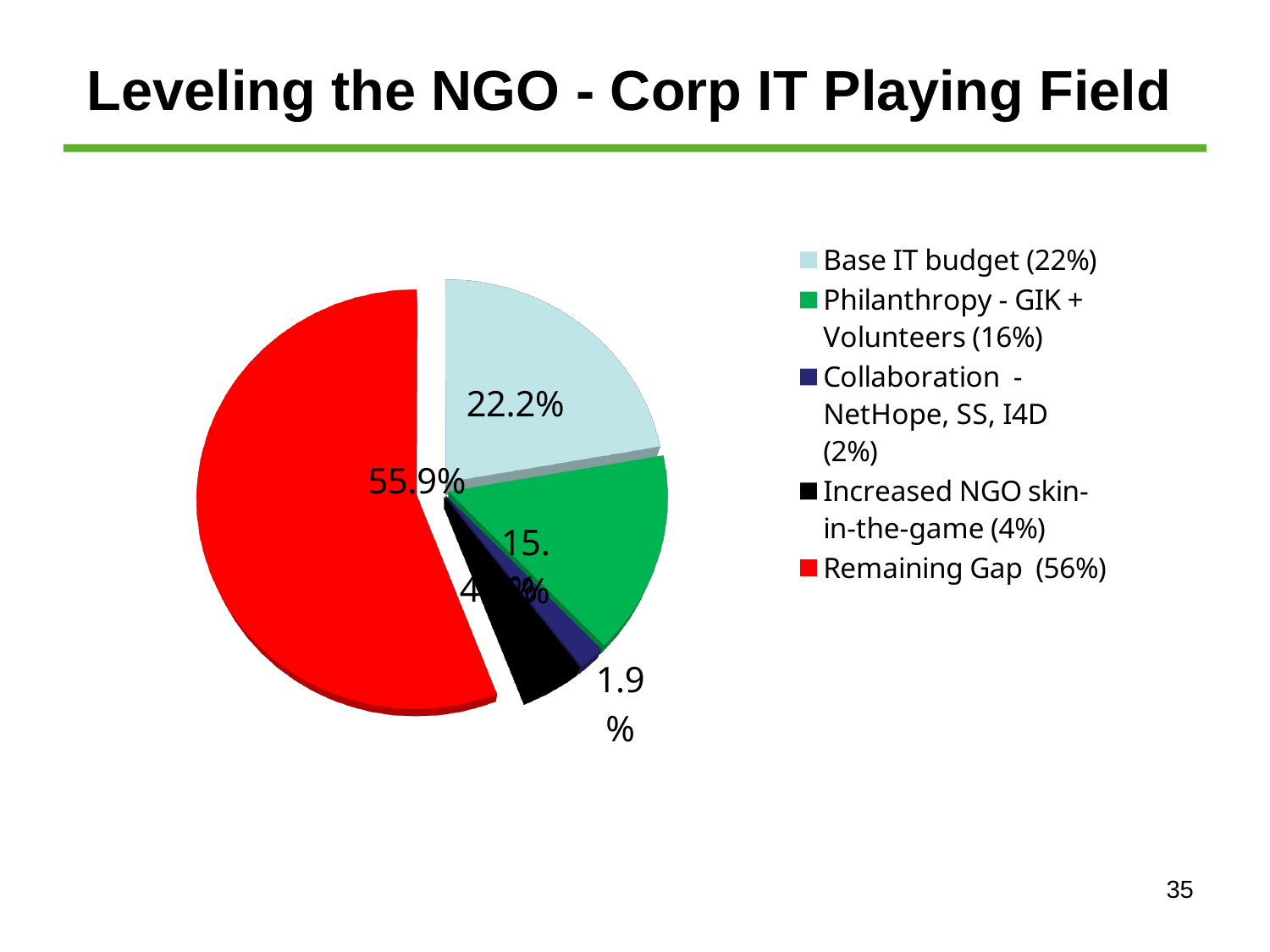
What is the data label shown on the Collaboration - NetHope, SS, I4D slice? 1.9% Which is larger: the Increased NGO skin-in-the-game slice or the Collaboration - NetHope, SS, I4D slice? Increased NGO skin-in-the-game What kind of chart is shown on the slide? pie chart What colour is the Remaining Gap slice? red Which is larger: the Base IT budget slice or the Philanthropy - GIK + Volunteers slice? Base IT budget What percentage does the legend give for Philanthropy - GIK + Volunteers? 16% Which category has the smallest slice of the pie? Collaboration - NetHope, SS, I4D Which category has the largest slice of the pie? Remaining Gap What is the data label shown on the Remaining Gap slice? 55.9% How many slices does the pie chart have? 5 By how many percentage points does the Remaining Gap data label exceed the Base IT budget data label? 33.7 What is the data label shown on the Base IT budget slice? 22.2%